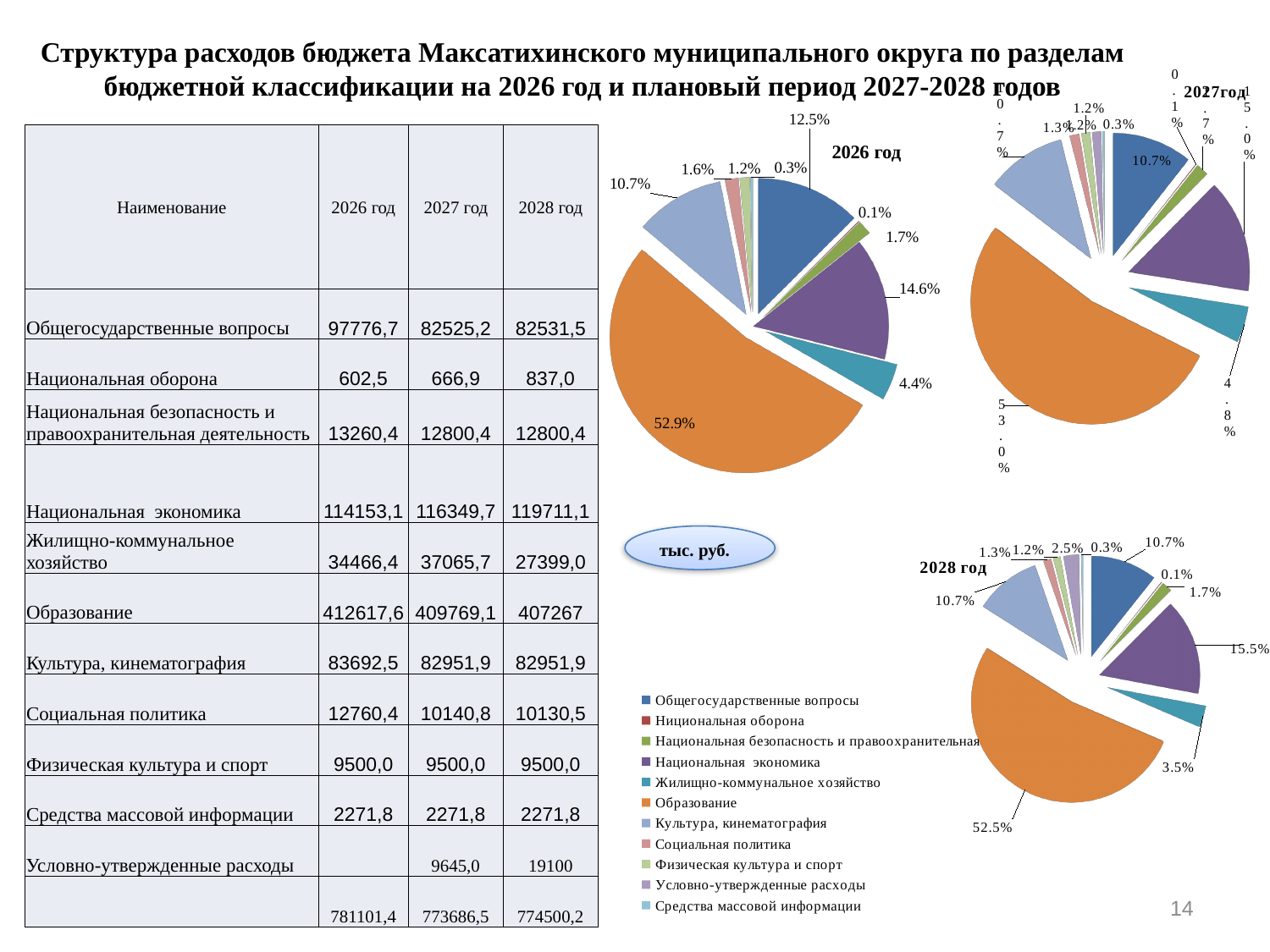
What kind of chart is used to show the 2026 год budget structure? pie chart In the 2028 год pie chart, what share does Условно-утвержденные расходы have? 2.5% How many categories does the legend list for the pie charts? 11 In the 2026 год pie chart, which category has the largest share? Образование In the 2028 год pie chart, what share does Образование have? 52.5% In the 2026 год pie chart, what is the difference in percentage points between the share of Образование and the share of Национальная экономика? 38.3 In the 2026 год pie chart, which is larger: the share of Национальная экономика or the share of Общегосударственные вопросы? Национальная экономика In the 2026 год pie chart, what share does Образование have? 52.9% In the 2027 год pie chart, is the share of Образование greater or less than 50%? greater In the 2026 год pie chart, which category has the smallest share? Национальная оборона